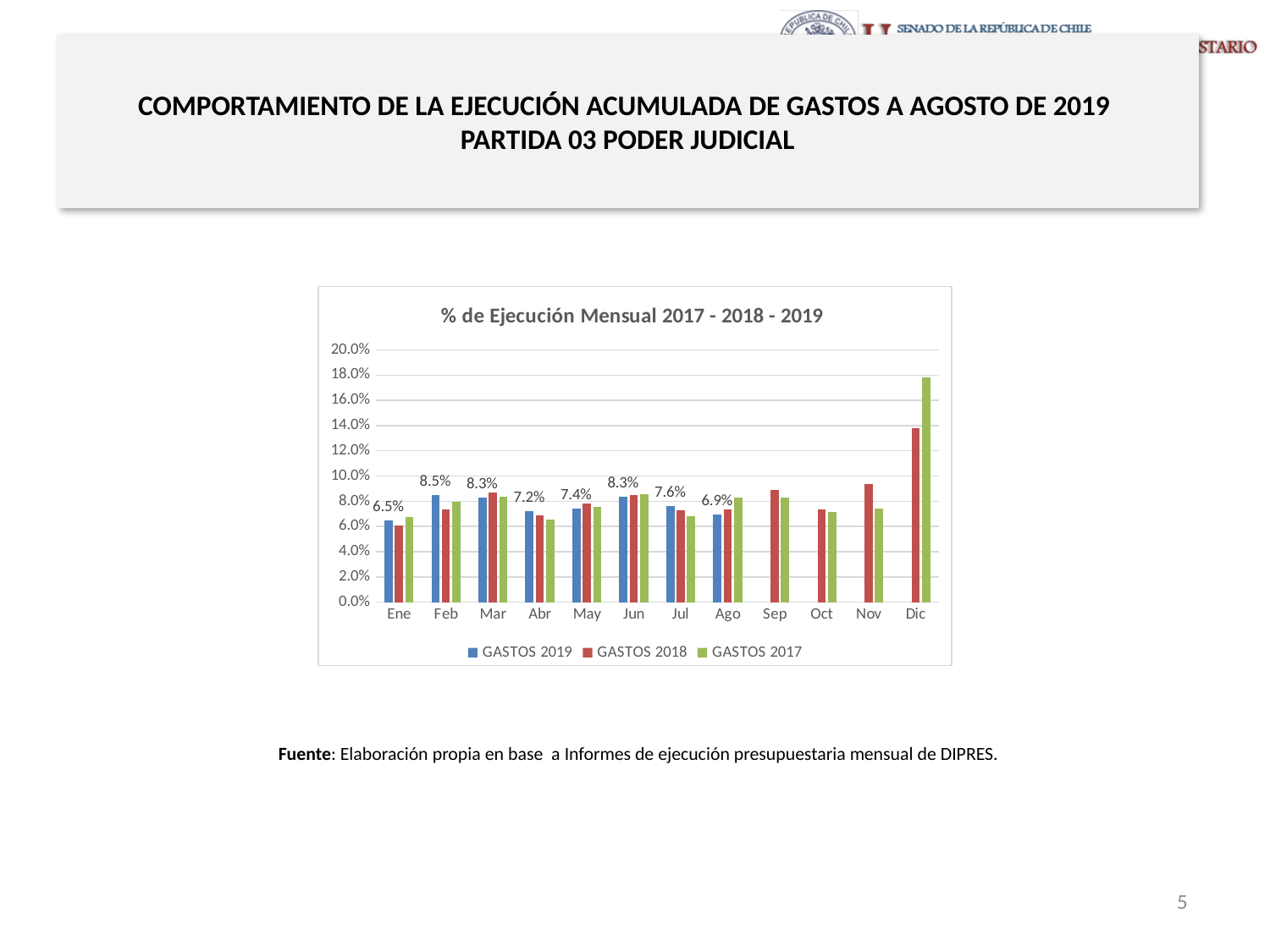
In which month is the GASTOS 2019 value highest? Feb How many months are shown on the x axis? 12 In which month is the GASTOS 2019 value lowest? Ene Is the value for GASTOS 2017 in Dic greater or less than 16.0%? greater What is the value for GASTOS 2019 in Ago? 6.9% What kind of chart is shown on the slide? bar chart Which month has the larger GASTOS 2019 value, Jul or Ago? Jul Is the value for GASTOS 2018 in Dic greater or less than 12.0%? greater What is the value for GASTOS 2019 in Ene? 6.5% What is the value for GASTOS 2019 in Feb? 8.5% How many series does the legend list? 3 What is the difference between the GASTOS 2019 values for Feb and Ene? 2.0%